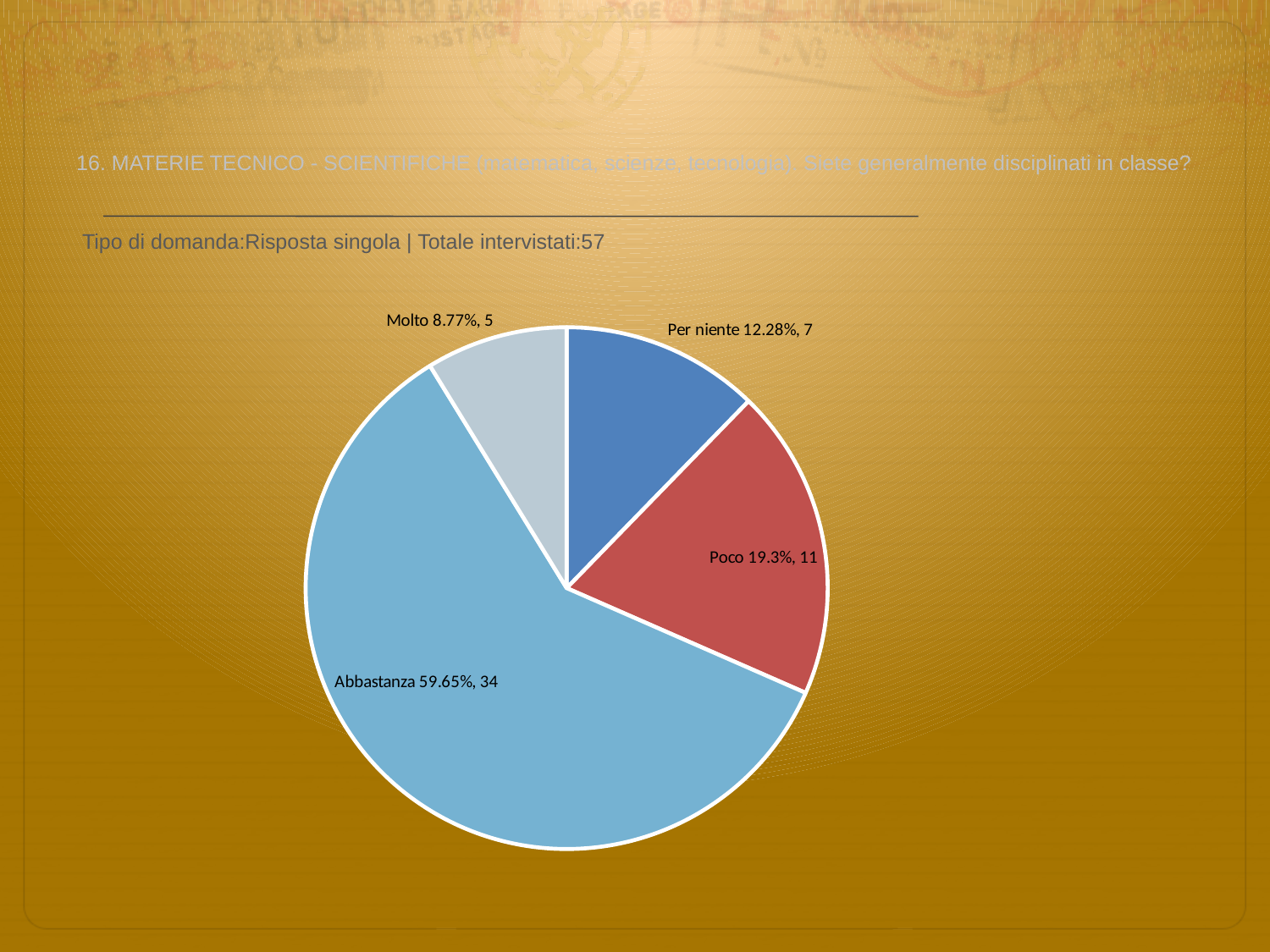
What kind of chart is shown on the slide? pie chart What colour is the 'Poco' slice? red What is the difference in count between 'Abbastanza' and 'Poco'? 23 How many respondents answered 'Molto'? 5 What percentage share does the 'Per niente' slice have? 12.28% What is the total number of respondents across all slices? 57 How many slices does the pie chart have? 4 Which has more respondents, 'Per niente' or 'Poco'? Poco How many respondents answered 'Poco'? 11 Which category has the largest slice? Abbastanza Which category has the smallest slice? Molto What percentage share does the 'Abbastanza' slice have? 59.65%